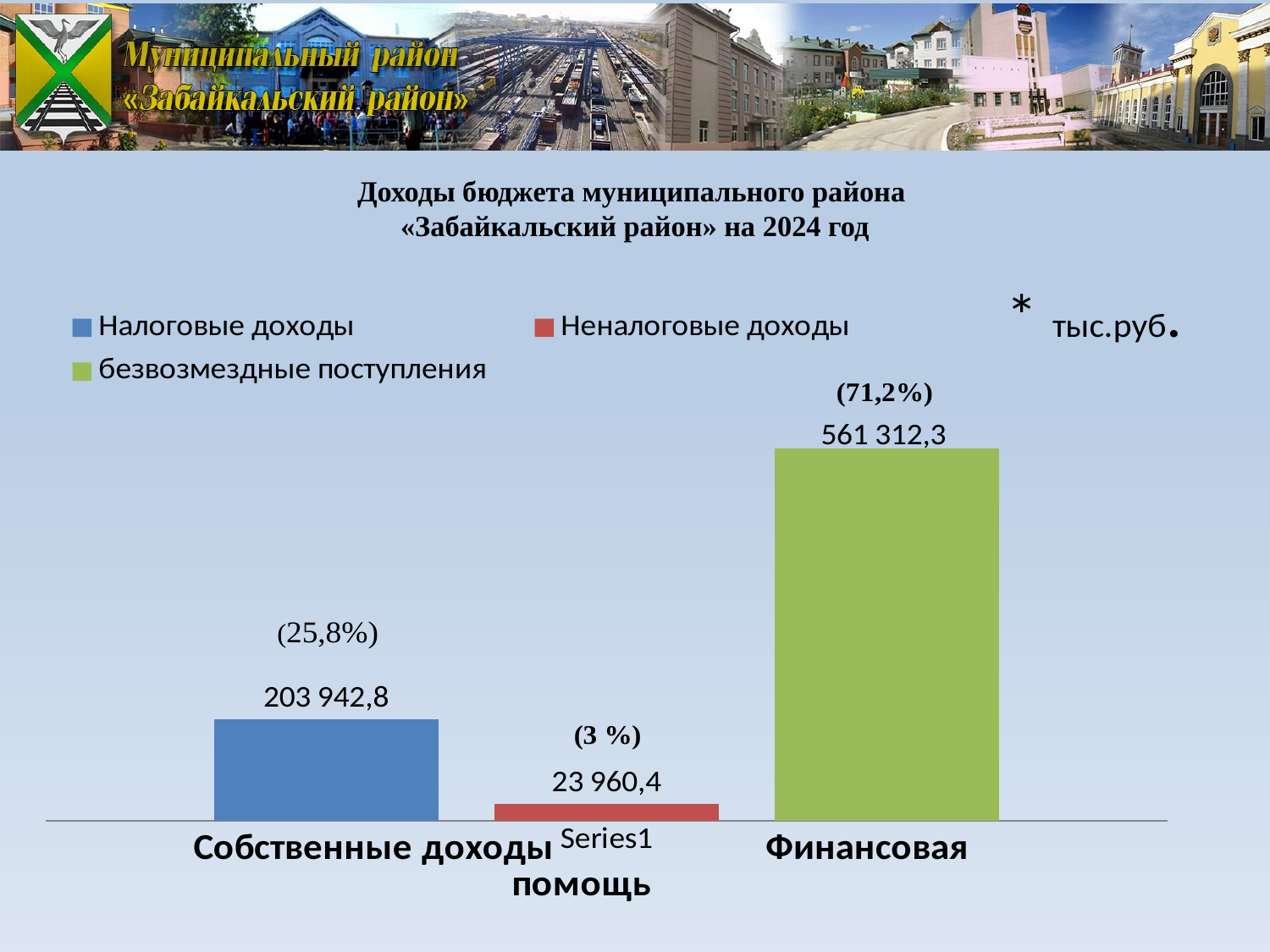
What is the value for безвозмездные поступления? 561 312,3 What percentage share is shown above the bar for безвозмездные поступления? 71,2% What type of chart is shown on the slide? bar chart Which is larger, Налоговые доходы or Неналоговые доходы? Налоговые доходы Which series has the lowest value? Неналоговые доходы How many series does the legend list? 3 What is the value for Неналоговые доходы? 23 960,4 What unit of measurement is indicated on the chart? тыс.руб. What is the value for Налоговые доходы? 203 942,8 What is the difference between безвозмездные поступления and Налоговые доходы? 357 369,5 What percentage share is shown above the bar for Налоговые доходы? 25,8% Which series has the highest value? безвозмездные поступления